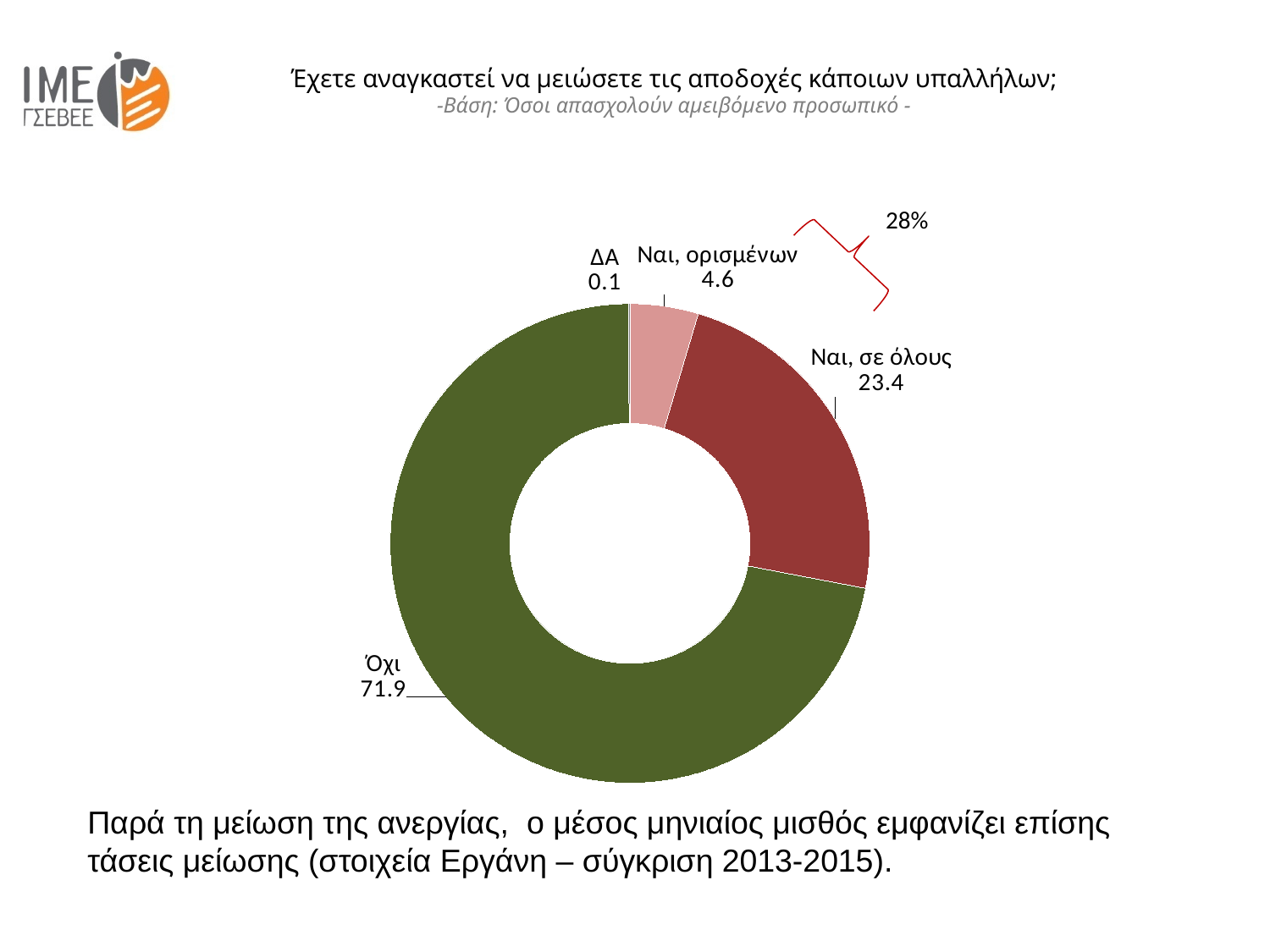
What kind of chart is shown on the slide? Doughnut (pie) chart What value is shown for the 'ΔΑ' slice? 0.1 What is the title of the chart? Έχετε αναγκαστεί να μειώσετε τις αποδοχές κάποιων υπαλλήλων; Which is larger, the value for 'Ναι, σε όλους' or the value for 'Ναι, ορισμένων'? Ναι, σε όλους What value is shown for the 'Όχι' slice? 71.9 How many categories are shown in the chart? 4 What value is shown for the 'Ναι, ορισμένων' slice? 4.6 Which category has the smallest slice? ΔΑ What combined percentage is indicated by the bracket grouping the two 'Ναι' slices? 28% What is the difference between the values for 'Όχι' and 'Ναι, σε όλους'? 48.5 Which category has the largest slice? Όχι What value is shown for the 'Ναι, σε όλους' slice? 23.4